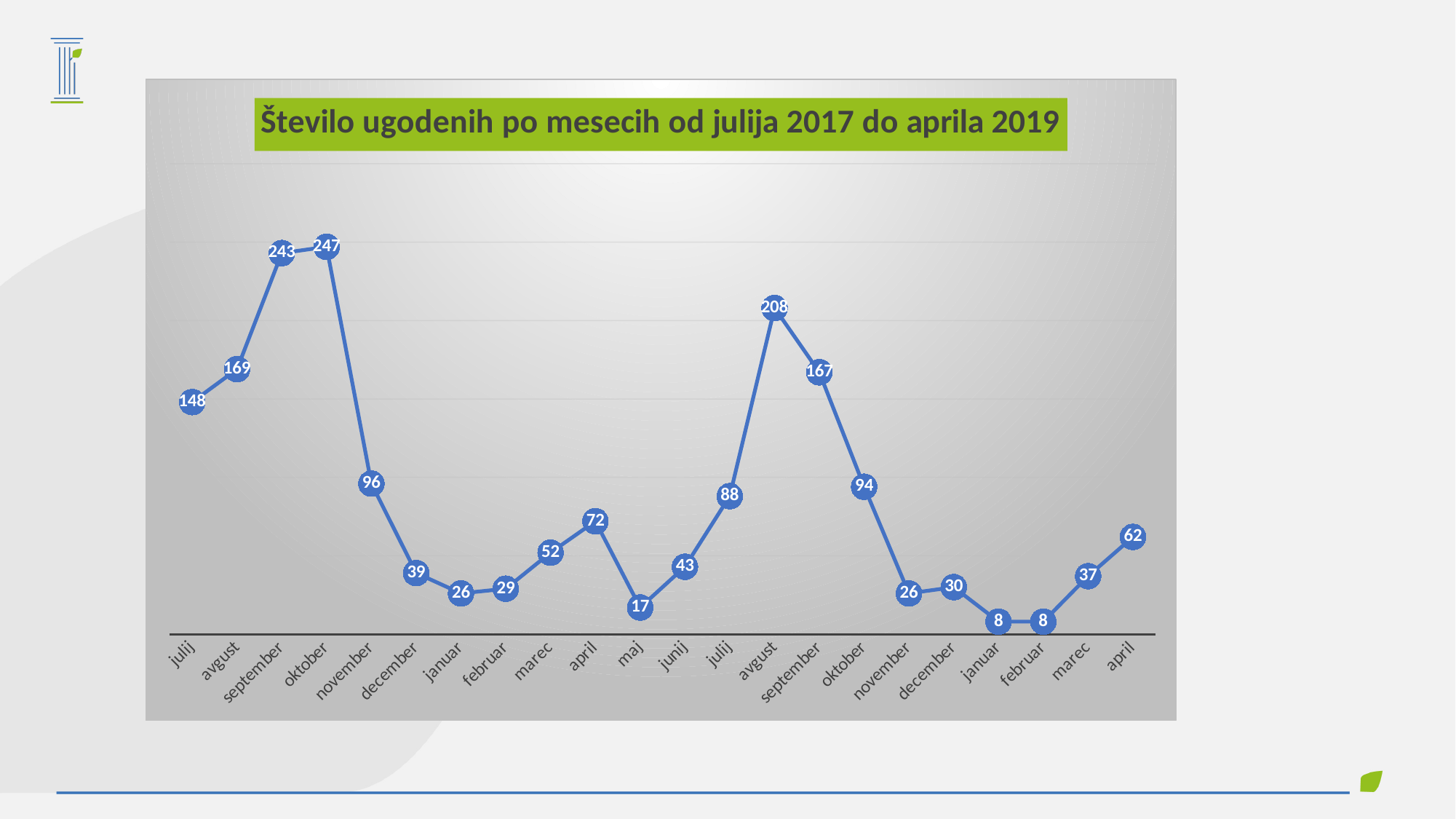
How many monthly data points are plotted on the chart? 22 Do the values rise or fall from januar 2019 to april 2019? rise What is the difference between the values for september 2017 and september 2018? 76 What is the value for the first maj (2018) on the chart? 17 What is the value for the first oktober (2017) on the chart? 247 What is the title of the chart? Število ugodenih po mesecih od julija 2017 do aprila 2019 What is the value for the second avgust (2018) on the chart? 208 What is the lowest value shown on the chart? 8 What type of chart is shown on the slide? line chart Which month has the highest value on the chart? oktober (2017) What is the value for the last point on the chart, april 2019? 62 Which is larger, the value for november 2017 or the value for oktober 2018? november 2017